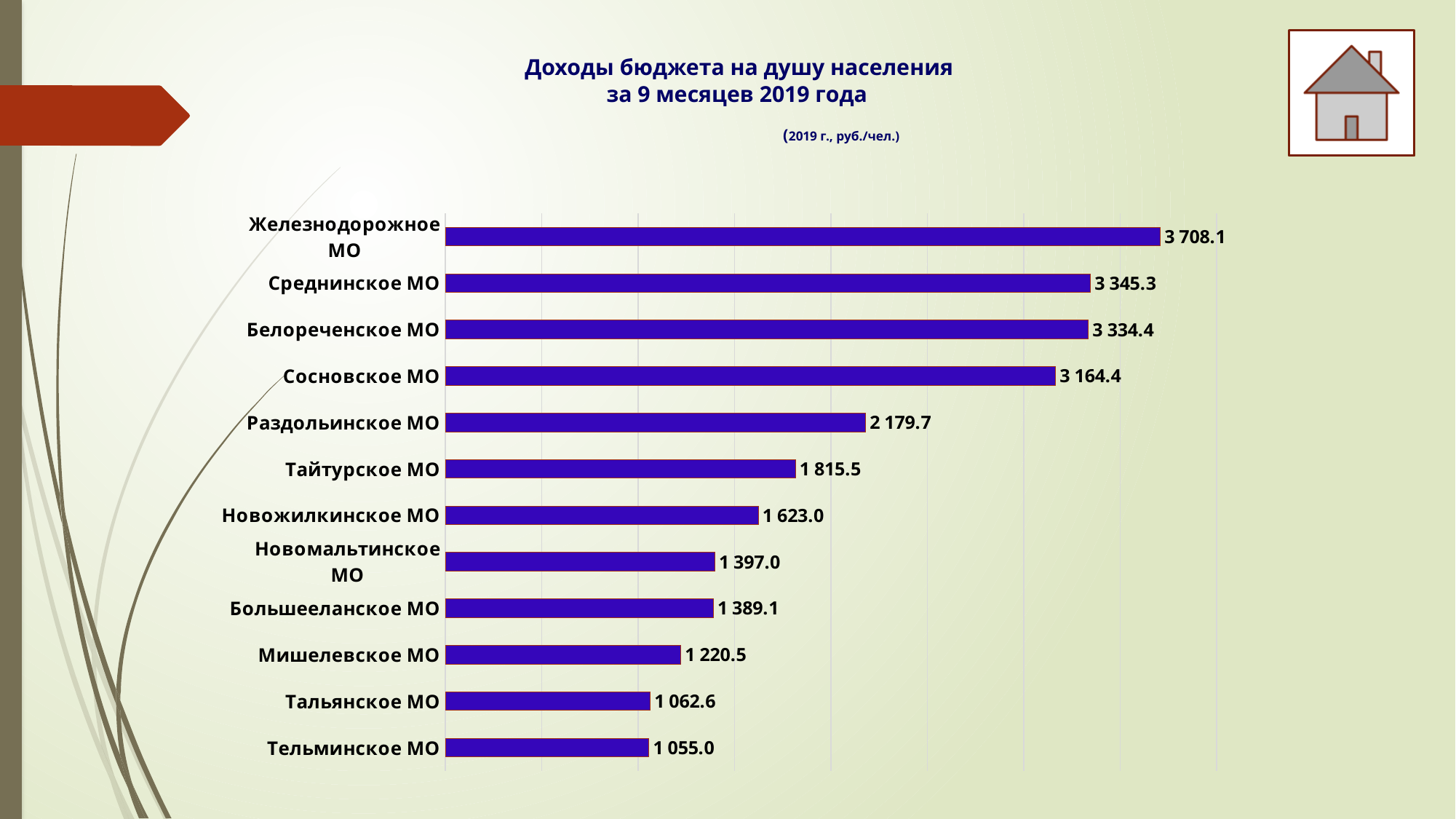
What is the value for Железнодорожное МО? 3 708.1 Which municipality has the highest value? Железнодорожное МО What is the value for Мишелевское МО? 1 220.5 Which is larger, the value for Сосновское МО or the value for Новожилкинское МО? Сосновское МО What is the difference between the values for Раздольинское МО and Тайтурское МО? 364.2 What kind of chart is shown on the slide? Bar chart Which is larger, the value for Тайтурское МО or the value for Большееланское МО? Тайтурское МО Which municipality has the lowest value? Тельминское МО What is the value for Раздольинское МО? 2 179.7 How many municipalities are shown in the chart? 12 What unit is given for the values in the chart? руб./чел. What is the difference between the values for Железнодорожное МО and Тельминское МО? 2 653.1